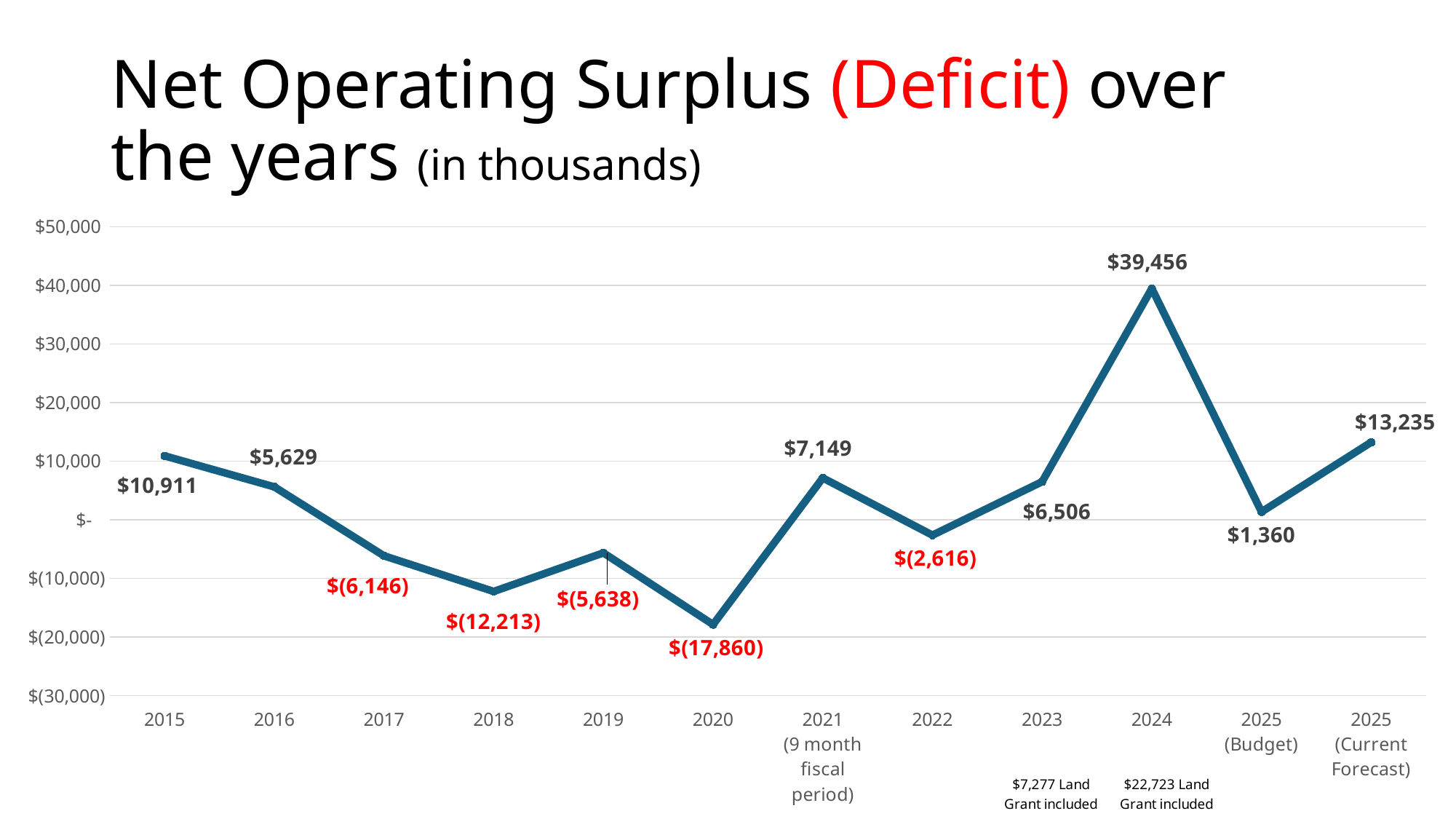
What is the value shown for 2025 (Current Forecast)? $13,235 Is the value for 2018 greater or less than $(10,000)? less Do the values rise or fall from 2015 to 2018? Fall What is the difference between the 2024 value and the 2025 (Current Forecast) value? $26,221 What kind of chart is shown on the slide? Line chart What is the net operating surplus value for 2015? $10,911 What is the value shown for 2024? $39,456 Which is larger, the value for 2021 (9 month fiscal period) or the value for 2023? 2021 (9 month fiscal period) Which year has the lowest value on the chart? 2020 What is the value shown for 2020? $(17,860) Which year has the highest value on the chart? 2024 How many data points are plotted on the line? 12